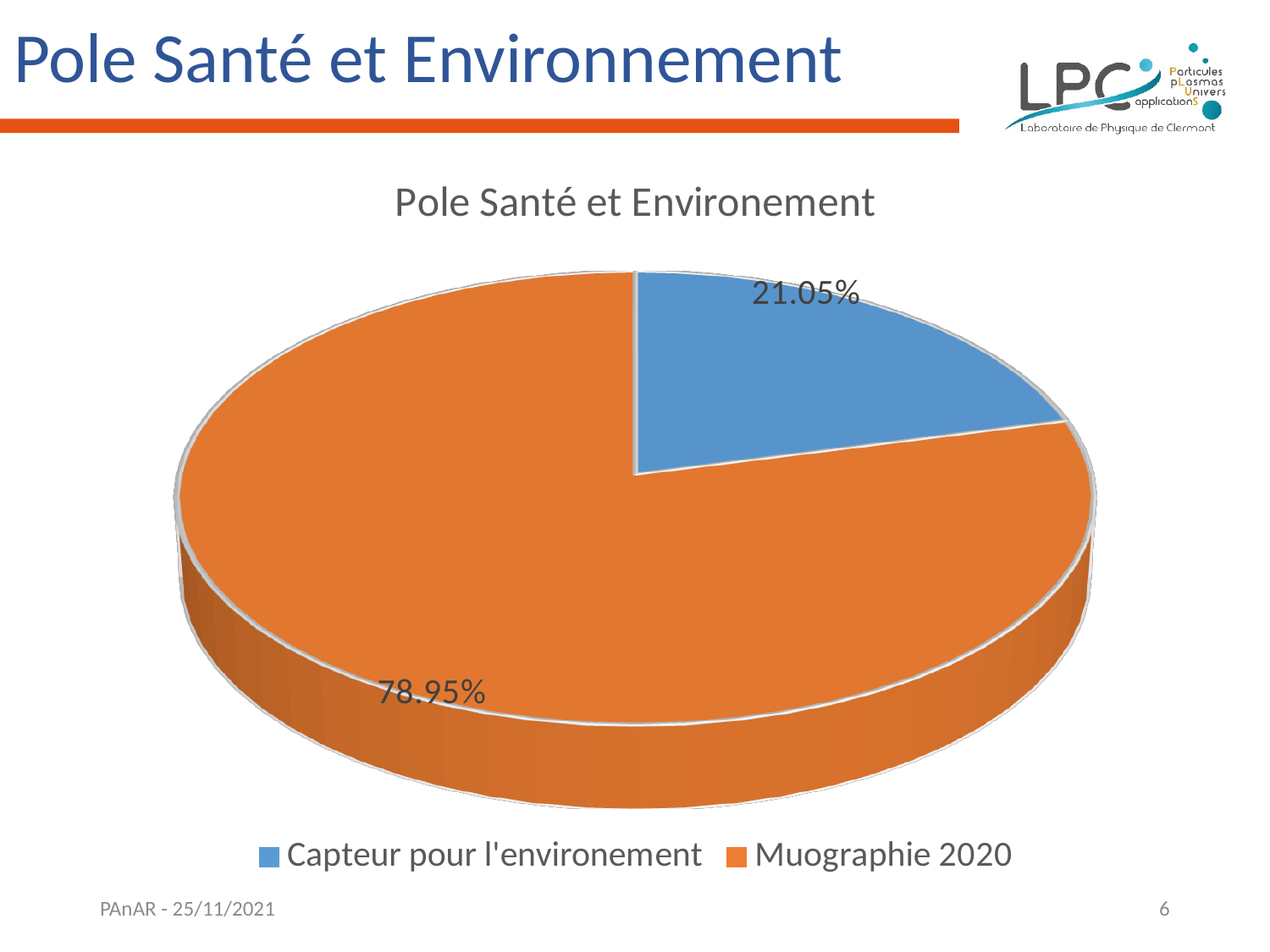
What is the difference in percentage points between the Muographie 2020 slice and the Capteur pour l'environement slice? 57.9 percentage points Which category has the largest slice of the pie? Muographie 2020 What share of the pie does Capteur pour l'environement represent? 21.05% Which is larger, the slice for Muographie 2020 or the slice for Capteur pour l'environement? Muographie 2020 Which category has the smallest slice of the pie? Capteur pour l'environement What type of chart is shown on the slide? Pie chart How many slices does the pie chart have? 2 What share of the pie does Muographie 2020 represent? 78.95% How many entries does the legend list? 2 What colour is the slice for Capteur pour l'environement? Blue What is the title of the chart? Pole Santé et Environement